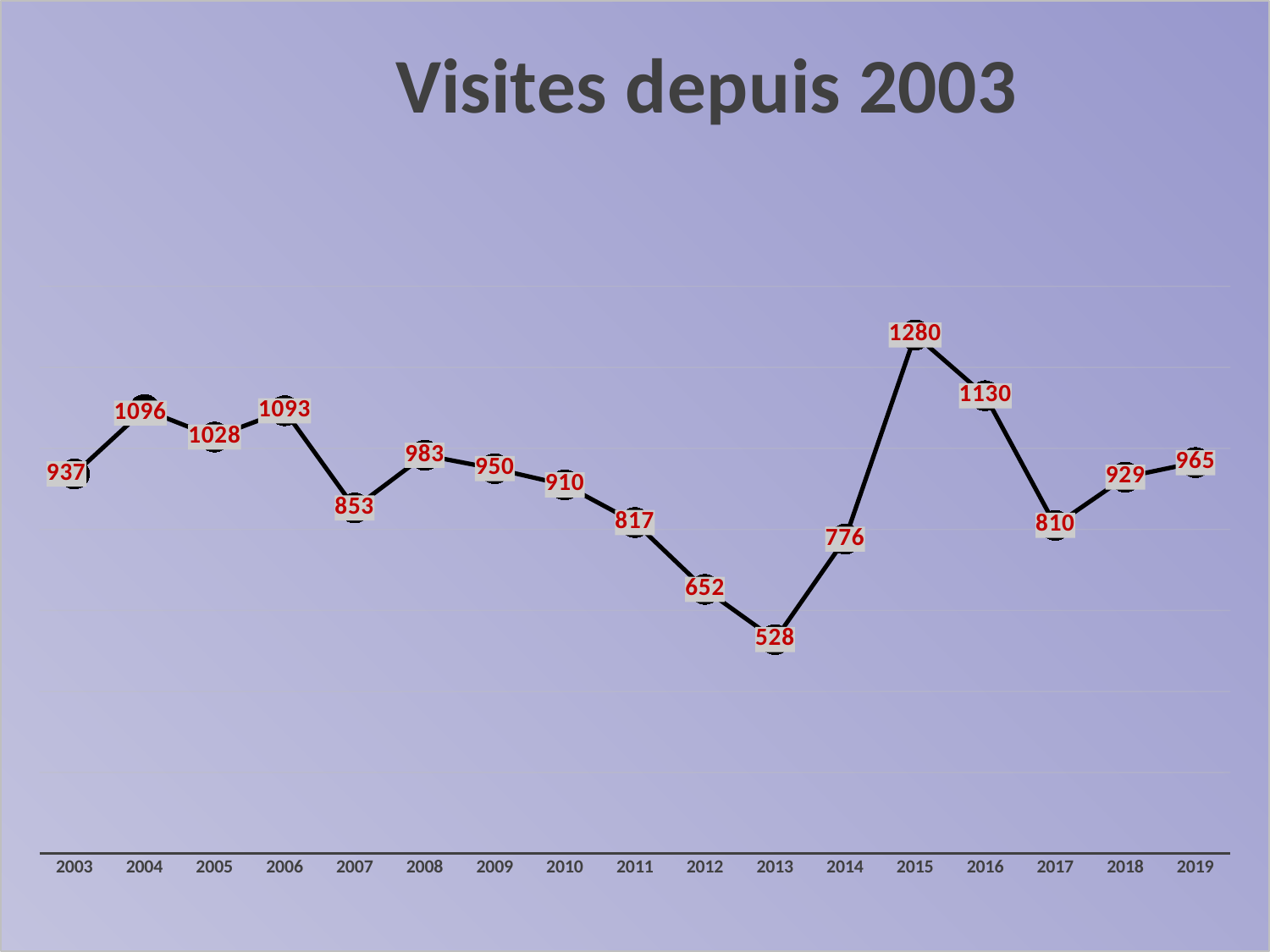
What kind of chart is shown? line chart Which year has the highest value? 2015 Which is larger, the value for 2006 or the value for 2004? 2004 Do the values rise or fall from 2008 to 2013? fall What is the value for 2007? 853 What is the value for 2015? 1280 Which is larger, the value for 2018 or the value for 2019? 2019 What is the difference between the values for 2015 and 2016? 150 How many years are plotted on the chart? 17 Which year has the lowest value? 2013 What is the value for 2013? 528 What is the difference between the values for 2004 and 2003? 159